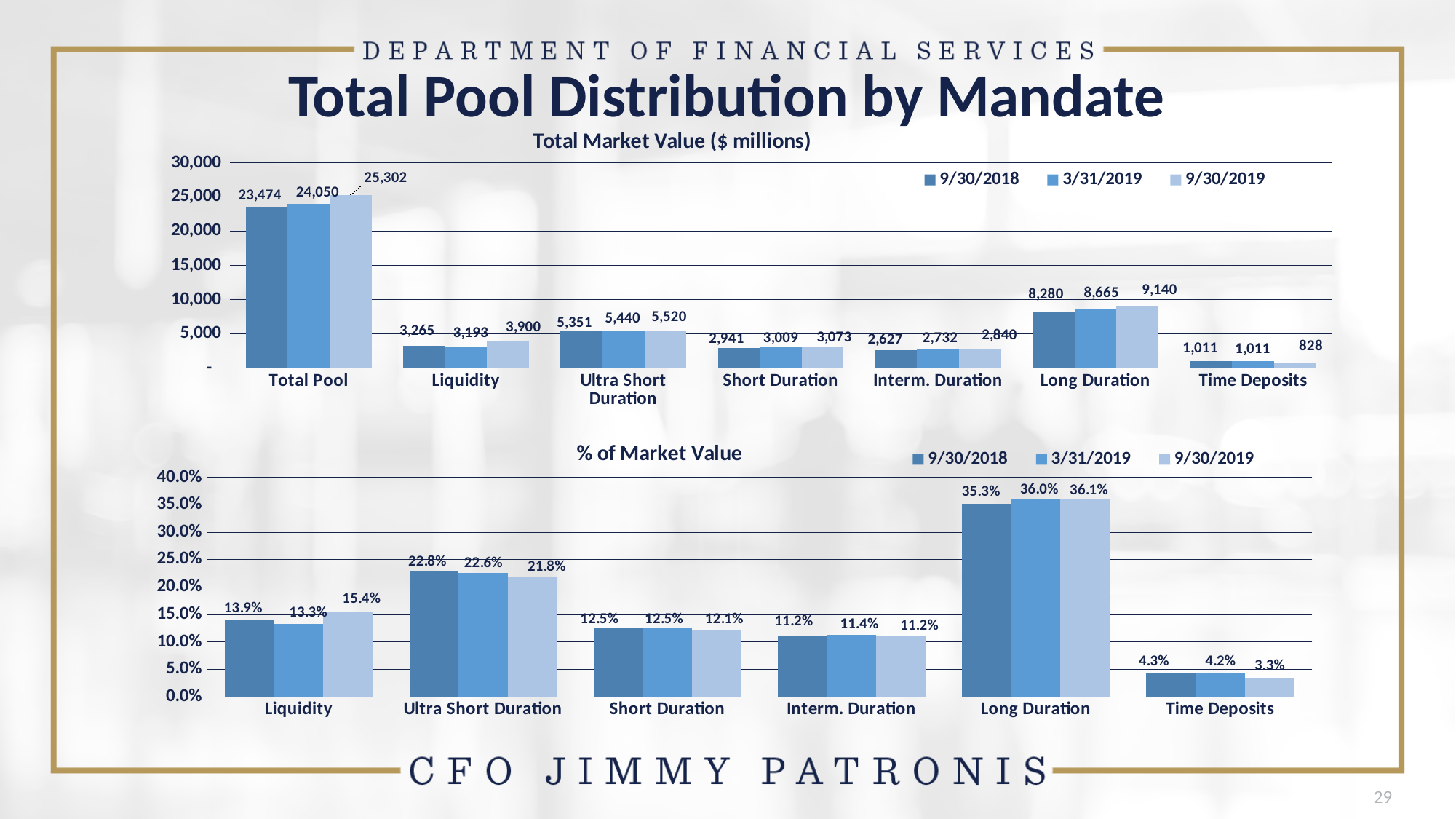
In the 'Total Market Value ($ millions)' chart, excluding Total Pool, which mandate has the highest value on 9/30/2019? Long Duration In the '% of Market Value' chart, which mandate has the lowest share on 3/31/2019? Time Deposits In the 'Total Market Value ($ millions)' chart, what is the difference between the Total Pool values on 9/30/2019 and 9/30/2018? 1,828 In the '% of Market Value' chart, what is the value for Liquidity on 9/30/2019? 15.4% In the 'Total Market Value ($ millions)' chart, what is the value for Time Deposits on 9/30/2019? 828 In the '% of Market Value' chart, what is the value for Long Duration on 9/30/2018? 35.3% What kind of chart is the '% of Market Value' chart? Bar chart In the '% of Market Value' chart, how many mandate categories are shown on the x axis? 6 In the 'Total Market Value ($ millions)' chart, which mandate has the lowest value on 9/30/2018? Time Deposits In the 'Total Market Value ($ millions)' chart, what is the value for Total Pool on 9/30/2019? 25,302 In the 'Total Market Value ($ millions)' chart, what is the value for Long Duration on 3/31/2019? 8,665 In the 'Total Market Value ($ millions)' chart, how many series does the legend list? 3